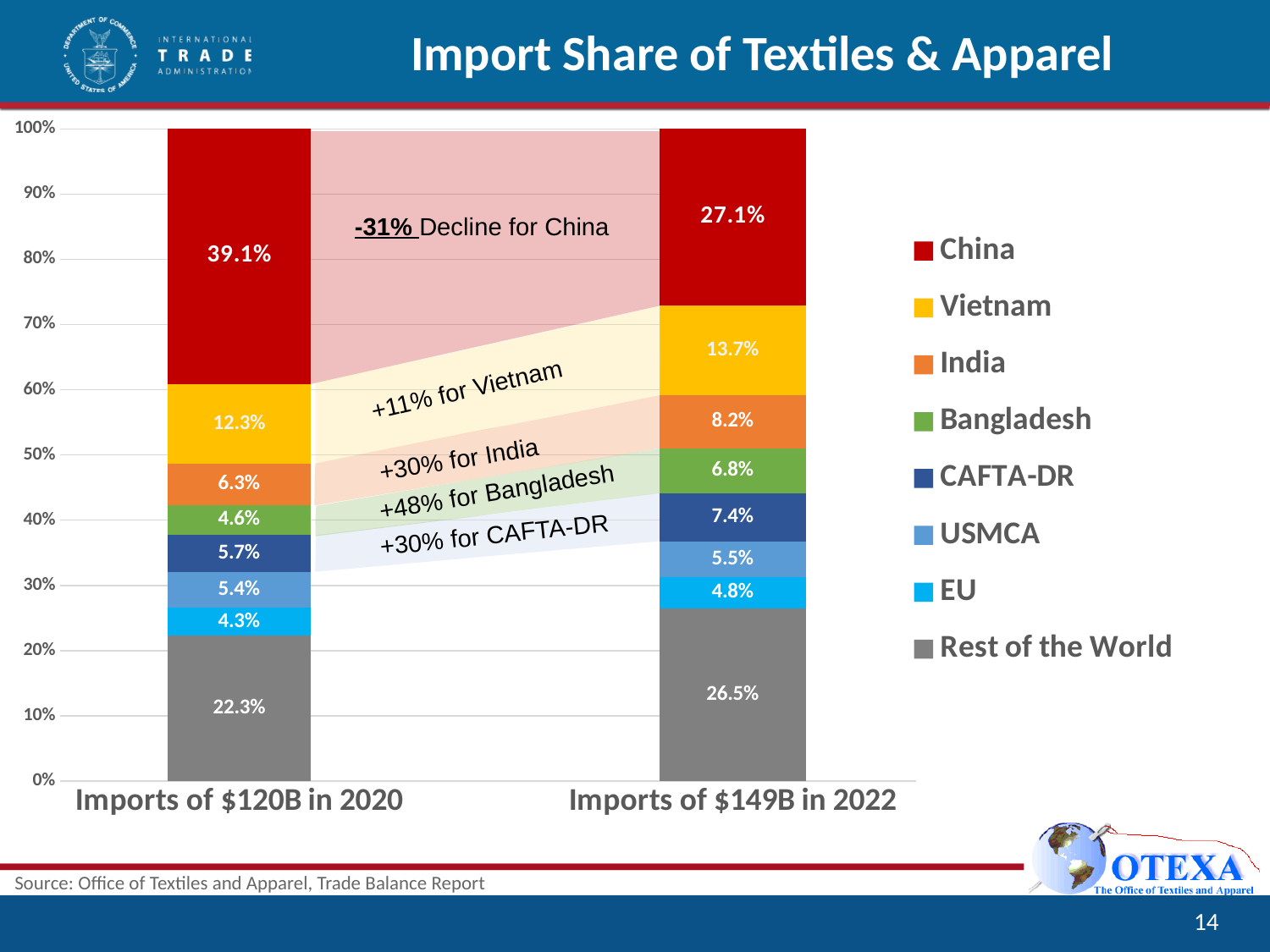
What is China's import share in the 'Imports of $149B in 2022' bar? 27.1% What is China's import share in the 'Imports of $120B in 2020' bar? 39.1% How many series does the legend list? 8 What kind of chart is shown on the slide? Stacked bar chart By how many percentage points did China's share fall from 2020 to 2022? 12.0 percentage points What is Vietnam's import share in 2022? 13.7% Which is larger in 2022: the share for India or the share for Bangladesh? India What is the share for CAFTA-DR in 2022? 7.4% Which series has the smallest share in the 2022 bar? EU Does Vietnam's share rise or fall from 2020 to 2022? Rise What is the share for Rest of the World in 2020? 22.3% Which series has the largest share in the 2020 bar? China